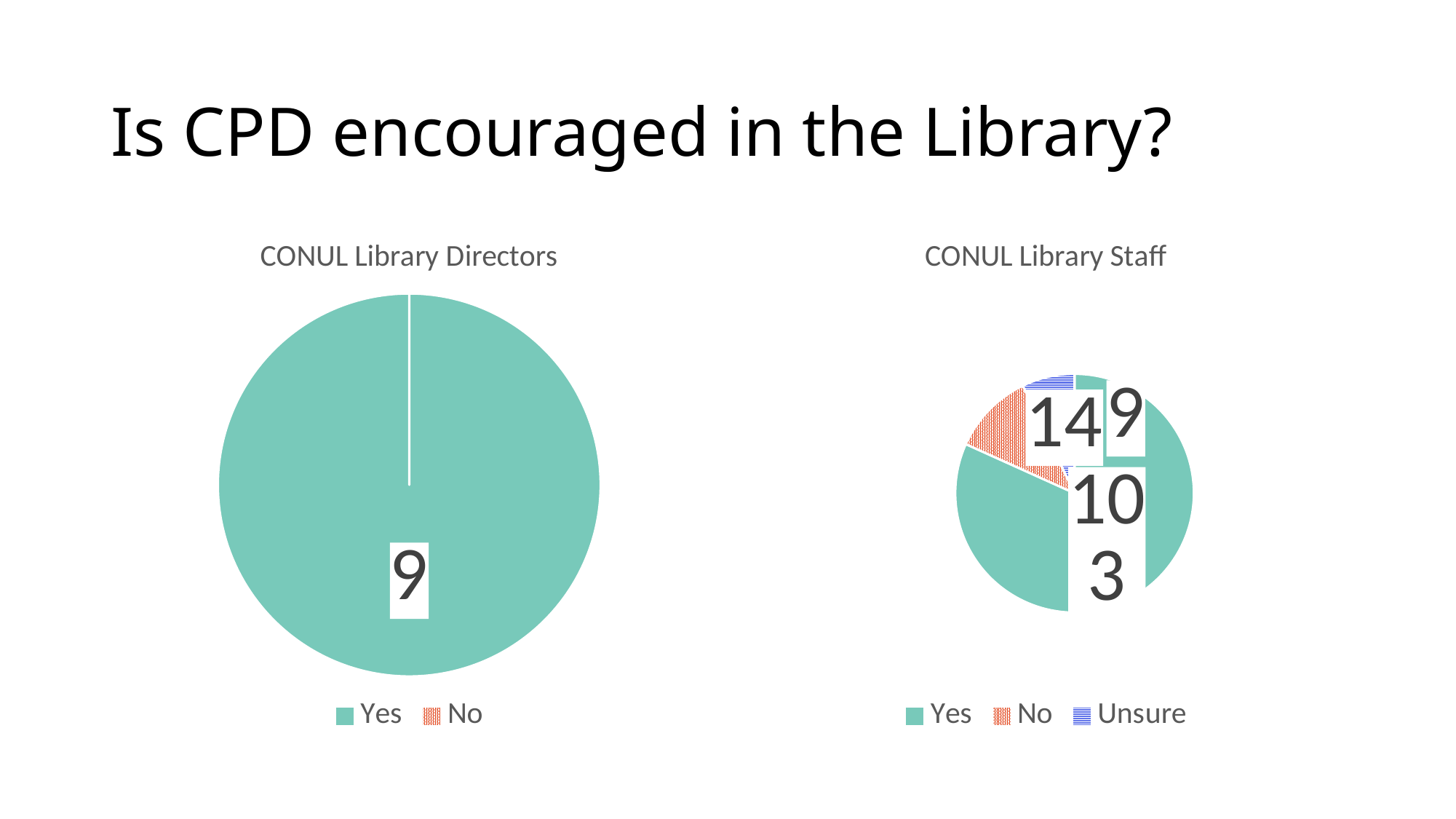
Which legend entry appears in the CONUL Library Staff chart but not in the CONUL Library Directors chart? Unsure In the CONUL Library Directors chart, which category has the largest slice? Yes What kind of chart is the CONUL Library Directors chart? pie chart In the CONUL Library Staff chart, which category has the largest slice? Yes How many entries does the legend of the CONUL Library Staff chart list? 3 In the CONUL Library Directors chart, what is the value for Yes? 9 What is the title of the chart on the left of the slide? CONUL Library Directors In the CONUL Library Staff chart, which slice is larger, Yes or No? Yes In the CONUL Library Staff chart, which category has the smallest slice? Unsure How many entries does the legend of the CONUL Library Directors chart list? 2 What kind of chart is the CONUL Library Staff chart? pie chart